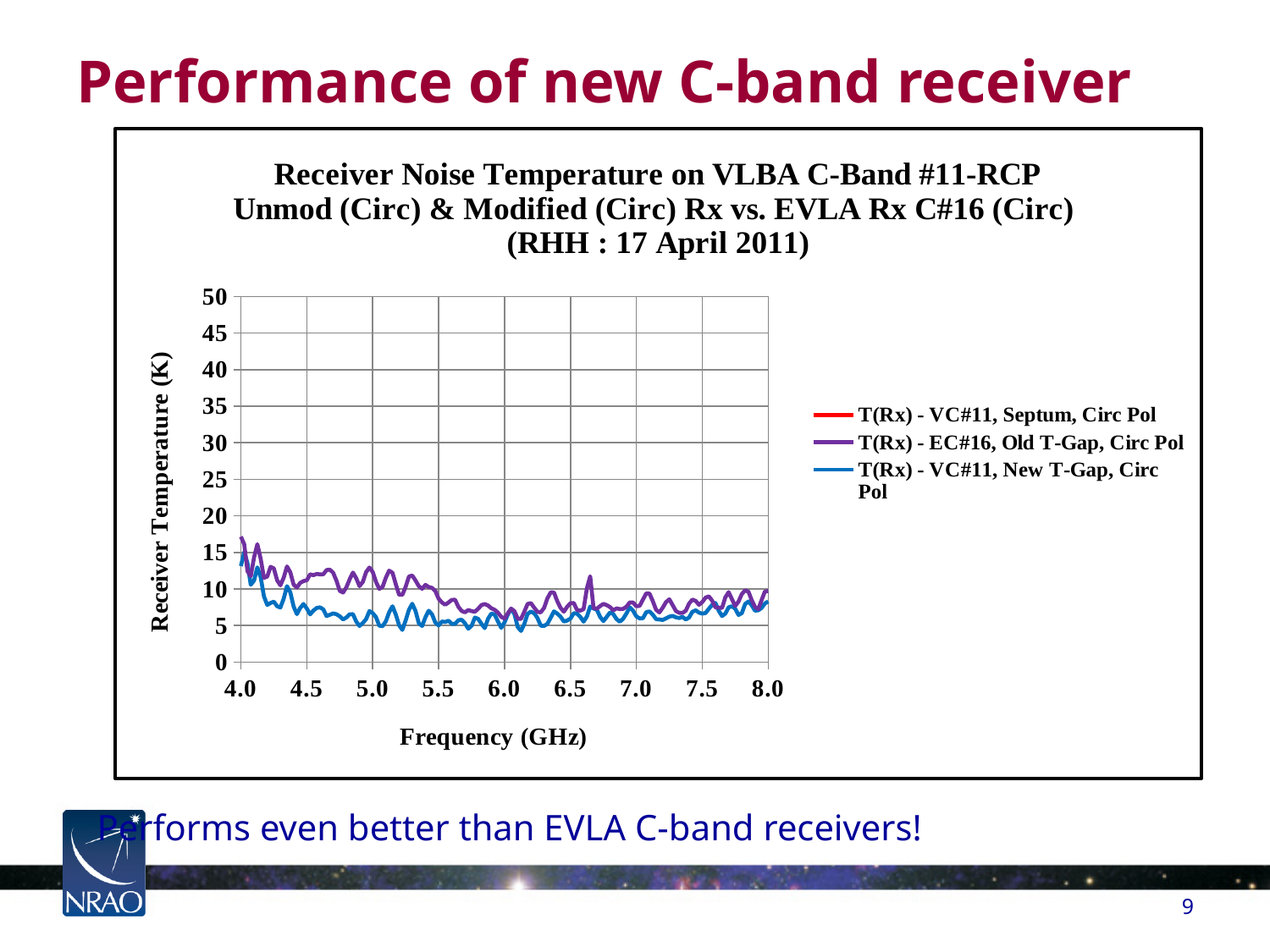
How many series does the chart's legend list? 3 Is the value of the T(Rx) - VC#11, New T-Gap, Circ Pol series at 6.0 GHz greater or less than 10? less Does the T(Rx) - VC#11, New T-Gap, Circ Pol series generally rise or fall between 4.0 GHz and 5.0 GHz? fall What is the title of the chart's horizontal axis? Frequency (GHz) Is the value of the T(Rx) - EC#16, Old T-Gap, Circ Pol series at 4.0 GHz greater or less than 20? less Does the T(Rx) - EC#16, Old T-Gap, Circ Pol series generally rise or fall between 4.0 GHz and 6.0 GHz? fall At 4.5 GHz, which series has the higher receiver temperature: T(Rx) - EC#16, Old T-Gap, Circ Pol or T(Rx) - VC#11, New T-Gap, Circ Pol? T(Rx) - EC#16, Old T-Gap, Circ Pol What is the highest value shown on the chart's vertical axis? 50 Is the value of the T(Rx) - VC#11, New T-Gap, Circ Pol series at 5.0 GHz greater or less than 10? less What is the title of the chart's vertical axis? Receiver Temperature (K) What kind of chart is shown on the slide? line chart